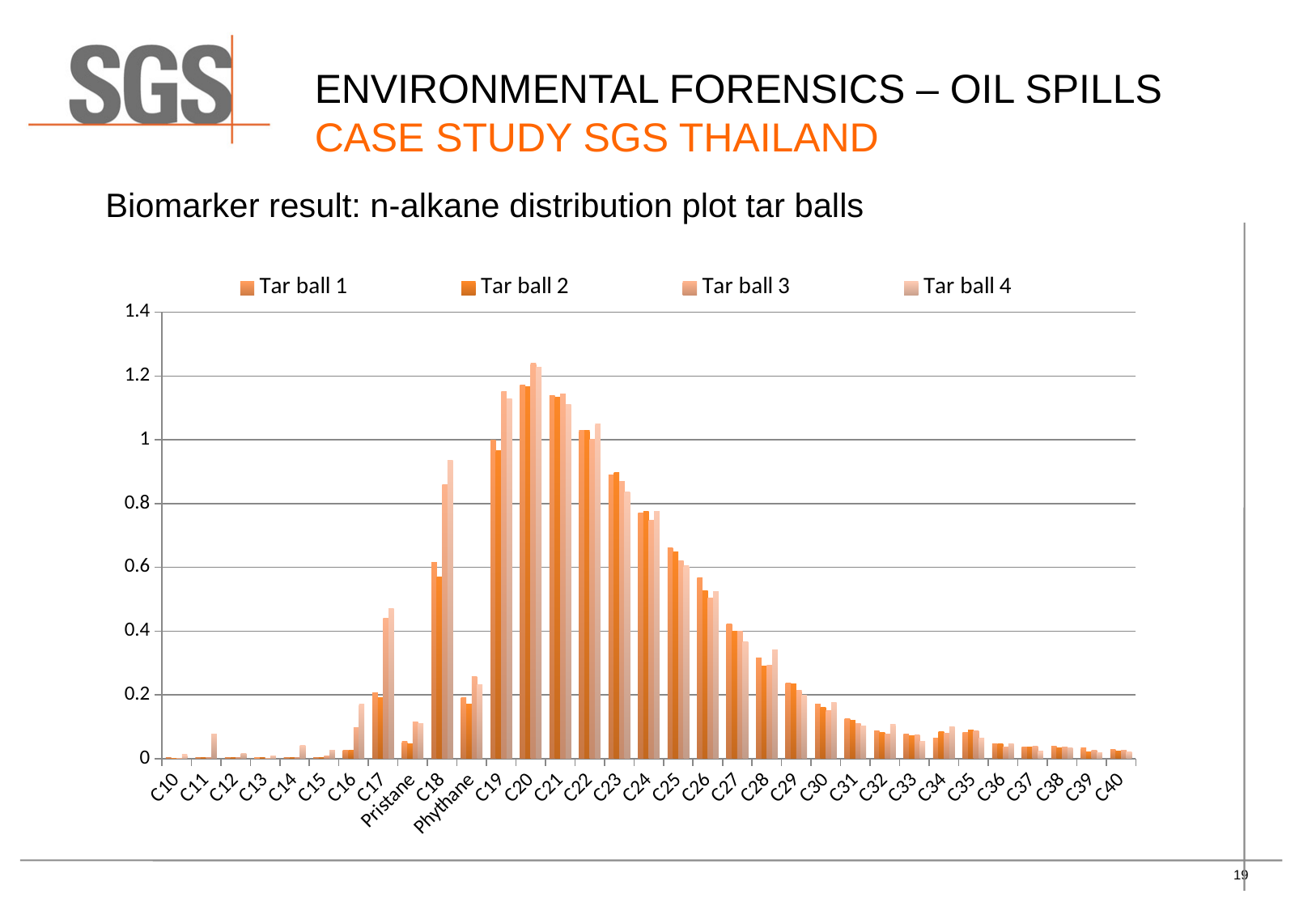
How many categories are shown on the x axis? 33 Which category has the highest values across the tar ball series? C20 Is the value for Tar ball 4 at C18 greater or less than 0.8? greater Do the values rise or fall along the x axis from C20 to C40? fall What kind of chart is shown on the slide? bar chart What are the names of the series in the legend? Tar ball 1, Tar ball 2, Tar ball 3, Tar ball 4 For Tar ball 1, which is larger: the value at C20 or the value at C40? C20 Is the value for Tar ball 1 at C19 greater or less than 0.8? greater For Tar ball 1, which is larger: the value at C18 or the value at Pristane? C18 Is the value for Tar ball 1 at C28 greater or less than 0.4? less How many series does the legend list? 4